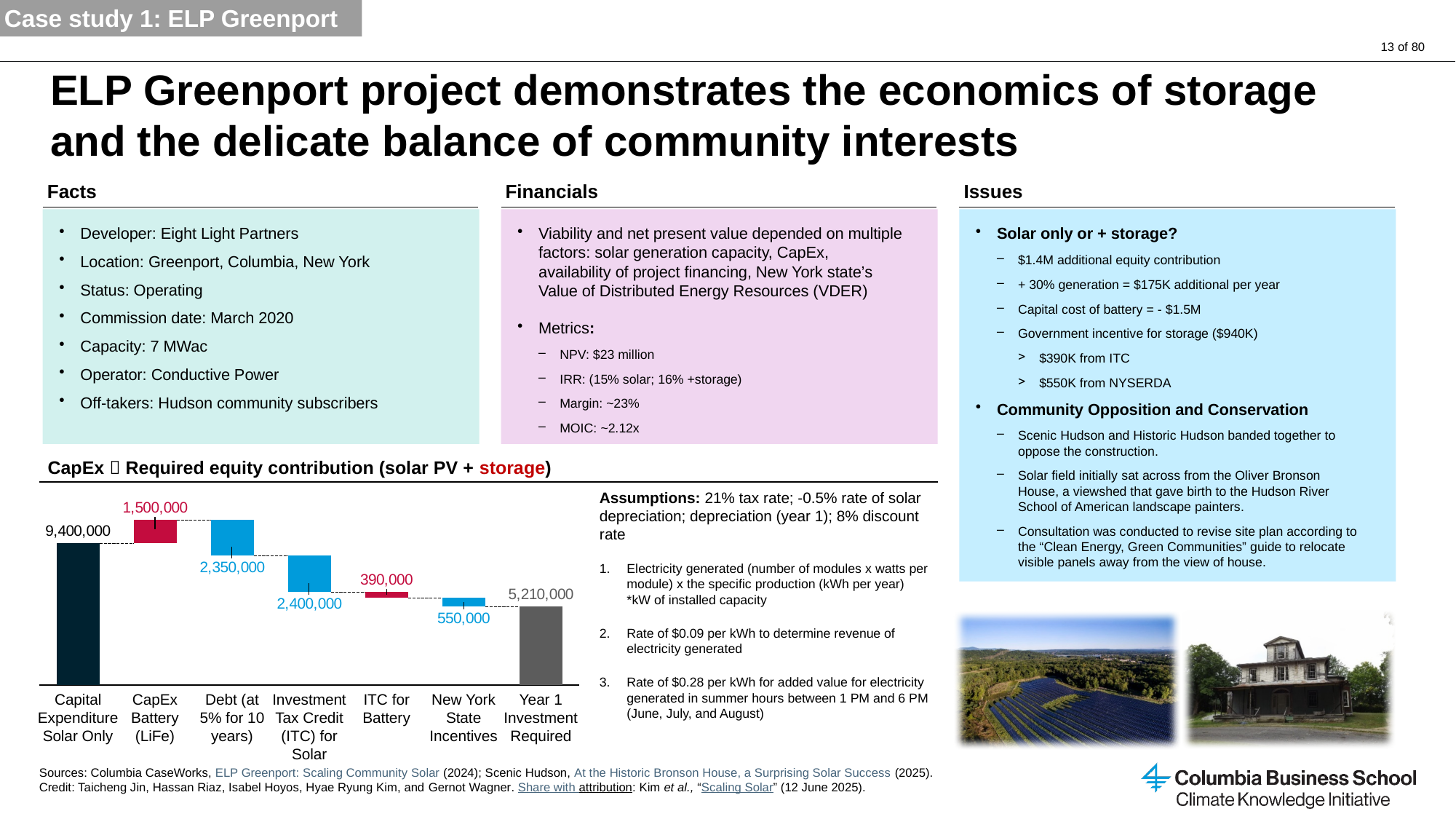
Which category in the chart has the smallest value? ITC for Battery How many categories are shown along the x axis of the chart? 7 What is the Year 1 Investment Required shown in the chart? 5,210,000 Which is larger: Investment Tax Credit (ITC) for Solar or Debt (at 5% for 10 years)? Investment Tax Credit (ITC) for Solar What is the value shown for ITC for Battery? 390,000 Which category in the chart has the largest value? Capital Expenditure Solar Only What is the value shown for Capital Expenditure Solar Only? 9,400,000 What is the value shown for CapEx Battery (LiFe)? 1,500,000 Which two categories in the chart are drawn in red? CapEx Battery (LiFe) and ITC for Battery What is the difference between Capital Expenditure Solar Only and Year 1 Investment Required? 4,190,000 What is the value shown for New York State Incentives? 550,000 What is the value shown for Debt (at 5% for 10 years)? 2,350,000